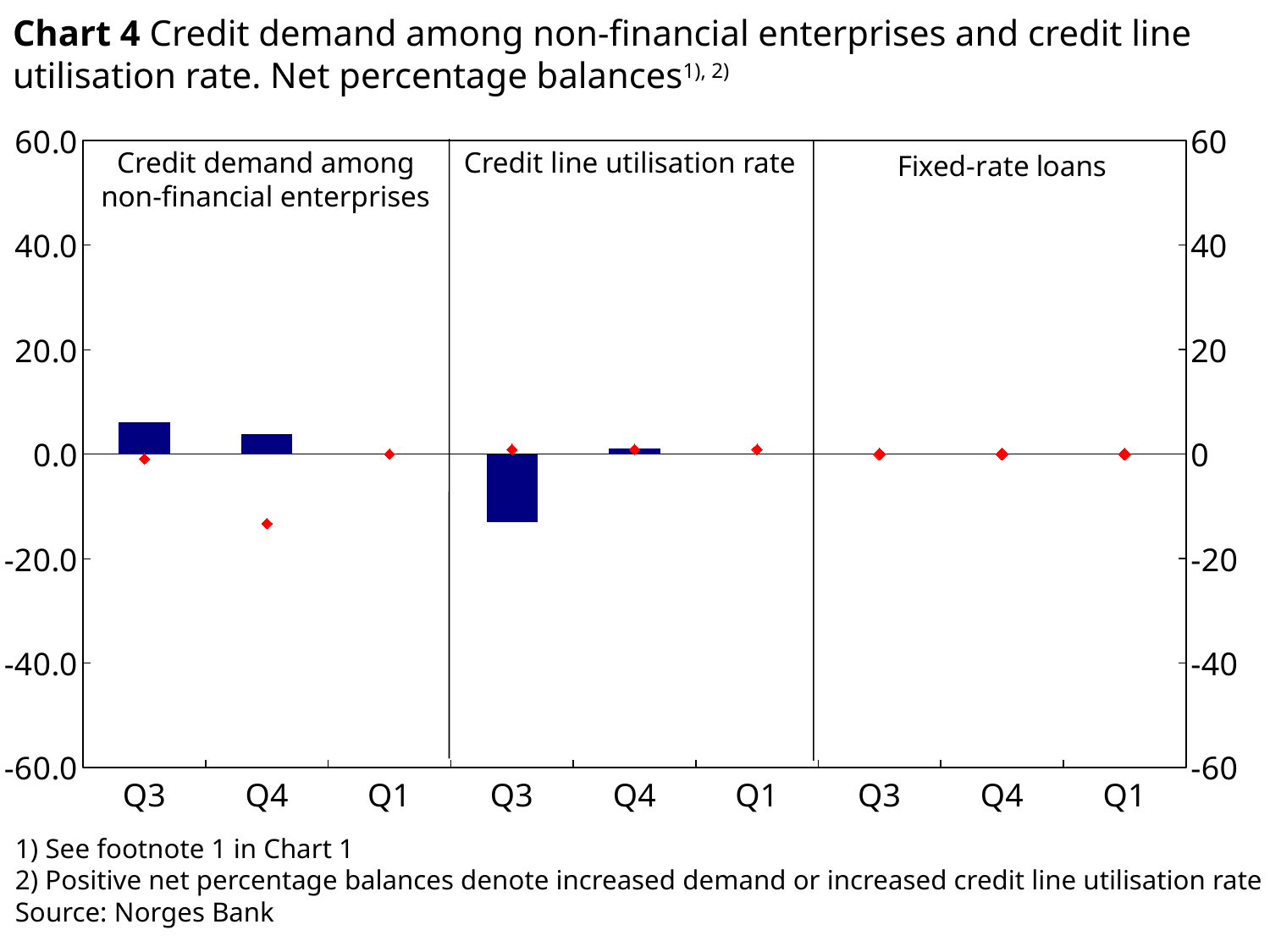
What kind of chart is Chart 4? combination bar and line chart (bars with red diamond markers) In the 'Credit demand among non-financial enterprises' panel, is the Q3 bar greater or less than 0? greater Do the bars in the 'Credit demand among non-financial enterprises' panel rise or fall from Q3 to Q1? fall Which bar in Chart 4 has the lowest value? Q3 in the Credit line utilisation rate panel In the 'Credit demand among non-financial enterprises' panel, which bar is taller, Q3 or Q4? Q3 How many panels (sections) is Chart 4 divided into? 3 In the 'Credit line utilisation rate' panel, is the Q3 bar greater or less than 0? less How many quarter categories are shown along the x axis of Chart 4 in total? 9 In the 'Credit line utilisation rate' panel, is the Q3 bar greater or less than -20? greater What is the source given for Chart 4? Norges Bank